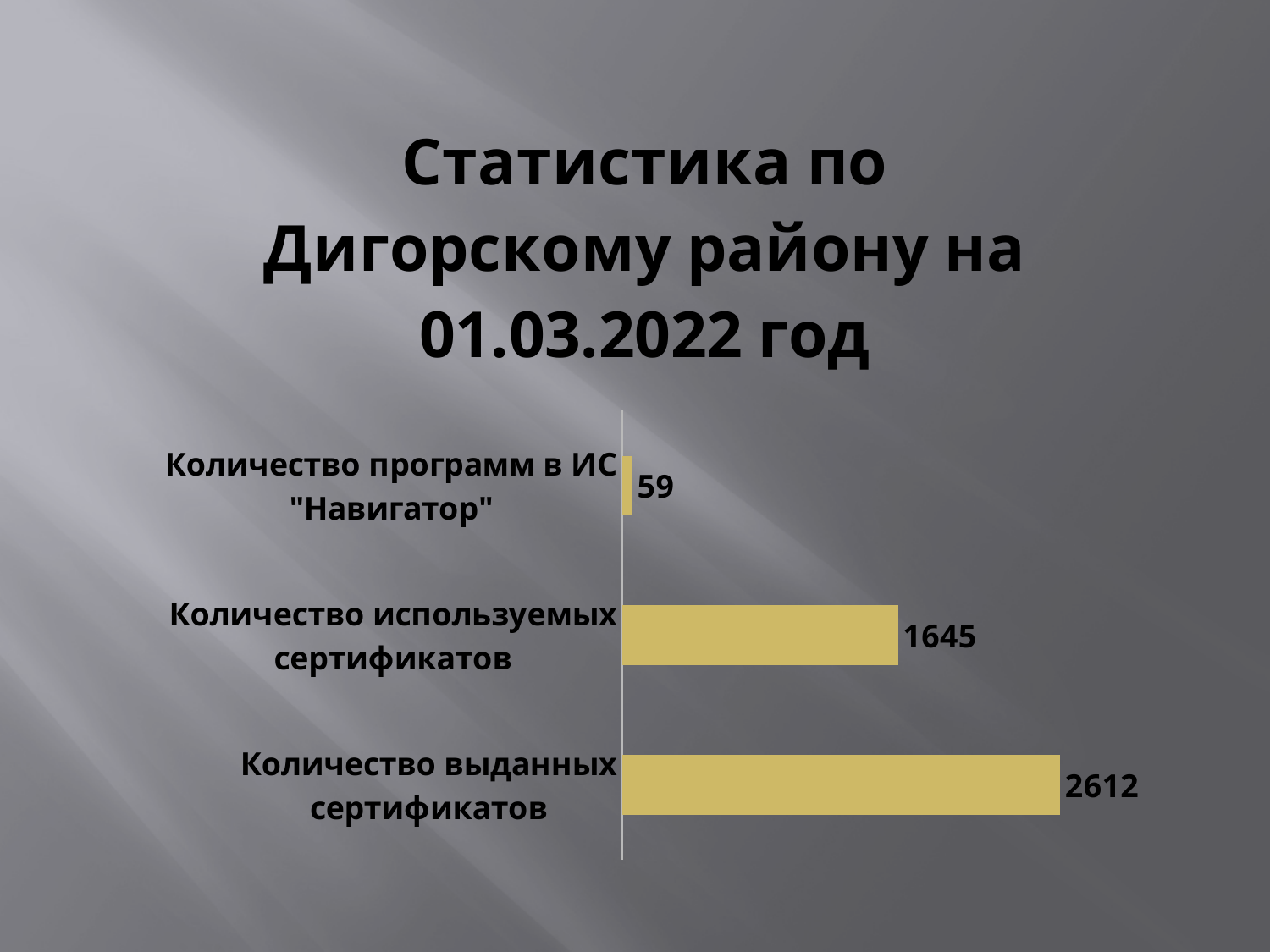
What is the value for "Количество выданных сертификатов"? 2612 Which category has the highest value? Количество выданных сертификатов What is the value for "Количество программ в ИС "Навигатор""? 59 Which is larger: the value for "Количество используемых сертификатов" or the value for "Количество программ в ИС "Навигатор""? Количество используемых сертификатов Which category has the lowest value? Количество программ в ИС "Навигатор" What colour are the bars in the chart? Yellow What is the difference between the number of issued certificates (Количество выданных сертификатов) and the number of used certificates (Количество используемых сертификатов)? 967 What is the difference between "Количество используемых сертификатов" and "Количество программ в ИС "Навигатор""? 1586 How many categories are shown in the chart? 3 What is the value for "Количество используемых сертификатов"? 1645 What kind of chart is shown on the slide? Bar chart What is the title of the slide containing the chart? Статистика по Дигорскому району на 01.03.2022 год